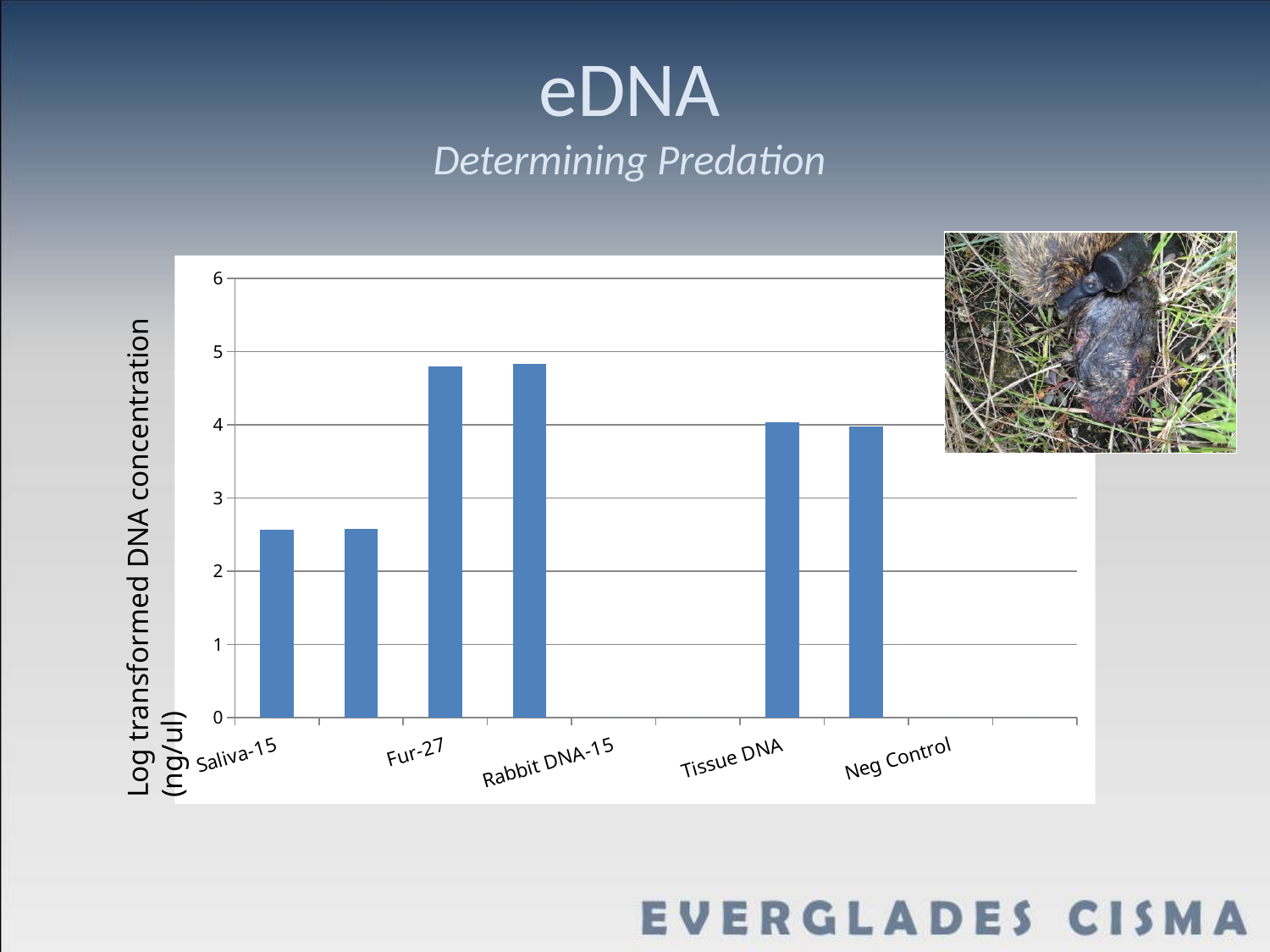
Which is larger, the value for Fur-27 or the value for Tissue DNA? Fur-27 What is the label of the vertical axis of the chart? Log transformed DNA concentration (ng/ul) Is the value for Tissue DNA greater or less than 3? greater How many category labels are readable along the x axis of the chart? 5 How many bars are plotted in the chart? 6 Is the value for Saliva-15 greater or less than 2? greater Is the value for Fur-27 greater or less than 5? less Which is larger, the value for Fur-27 or the value for Saliva-15? Fur-27 What is the highest value shown on the vertical axis of the chart? 6 What kind of chart is shown on the slide? Bar chart